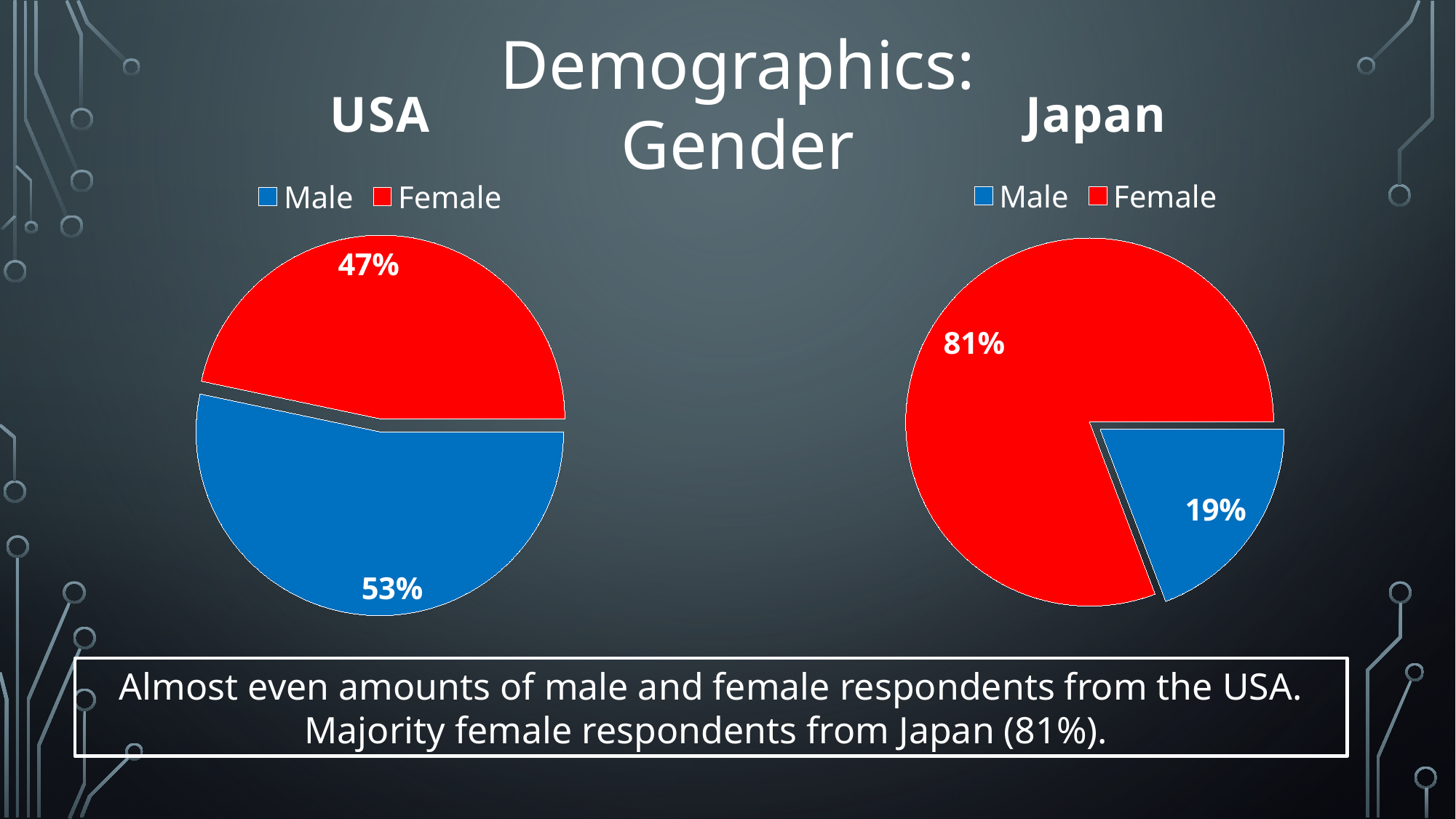
In the USA chart, what colour represents Male? blue In the Japan chart, what is the difference between the Female and Male percentages? 62% How many categories does the legend of the Japan chart list? 2 In the Japan chart, what percentage of respondents are Male? 19% What type of chart is the USA chart? pie chart In the USA chart, which category has the smallest slice? Female In the USA chart, what percentage of respondents are Female? 47% In the Japan chart, what percentage of respondents are Female? 81% In the Japan chart, is the Male slice larger or smaller than the Female slice? smaller In the USA chart, what is the difference between the Male and Female percentages? 6% In the USA chart, what percentage of respondents are Male? 53% In the Japan chart, which category has the largest slice? Female